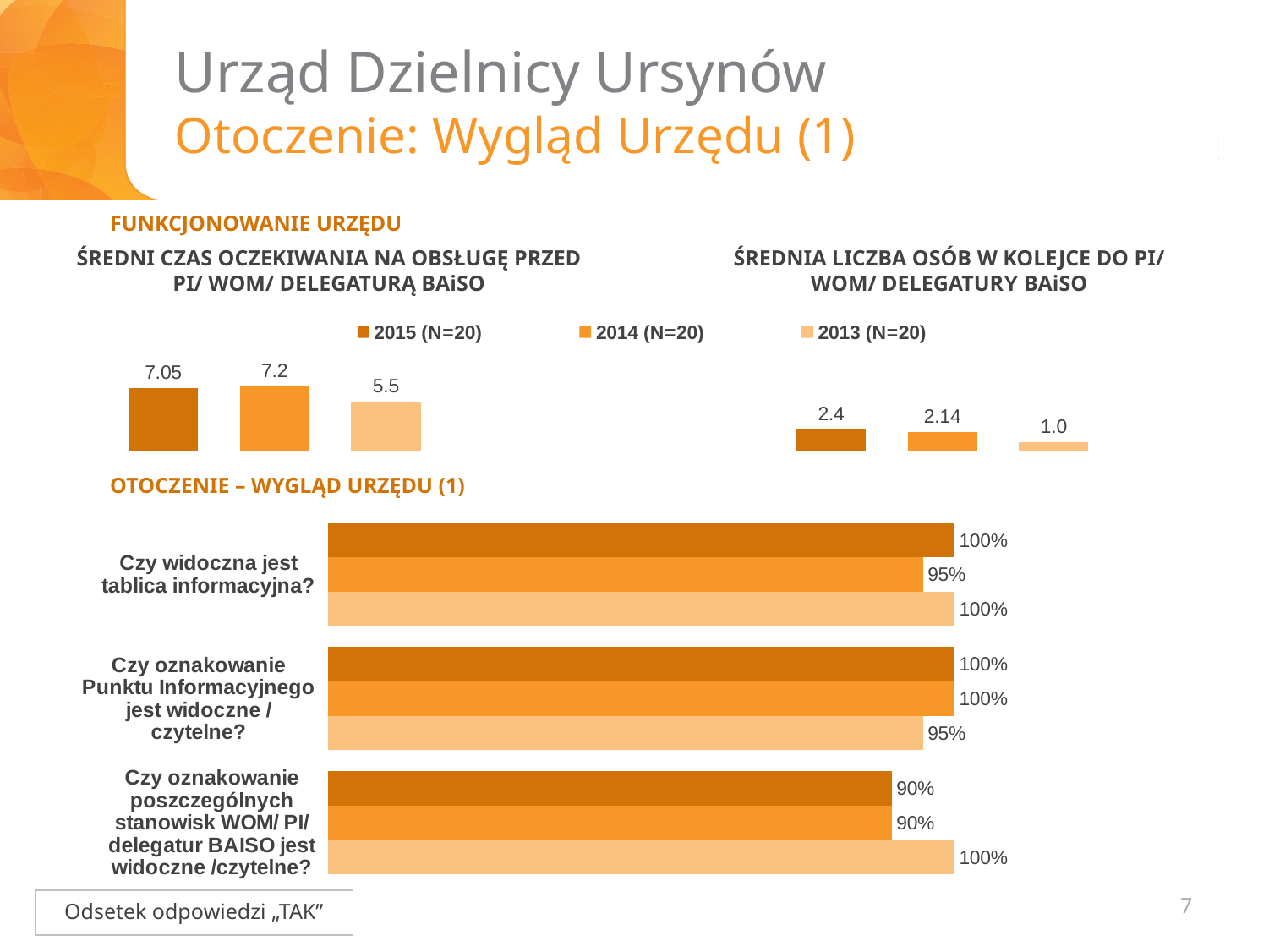
In the chart 'ŚREDNI CZAS OCZEKIWANIA NA OBSŁUGĘ PRZED PI/ WOM/ DELEGATURĄ BAiSO', what is the difference between the 2014 and 2013 values? 1.7 In the chart 'ŚREDNI CZAS OCZEKIWANIA NA OBSŁUGĘ PRZED PI/ WOM/ DELEGATURĄ BAiSO', what is the value for 2015 (N=20)? 7.05 In the chart 'OTOCZENIE – WYGLĄD URZĘDU (1)', what is the 2014 value for 'Czy widoczna jest tablica informacyjna?'? 95% In the chart 'OTOCZENIE – WYGLĄD URZĘDU (1)', how many questions (categories) are shown? 3 In the chart 'ŚREDNIA LICZBA OSÓB W KOLEJCE DO PI/ WOM/ DELEGATURY BAiSO', what is the difference between the 2015 and 2013 values? 1.4 In the chart 'OTOCZENIE – WYGLĄD URZĘDU (1)', what is the 2015 value for 'Czy oznakowanie poszczególnych stanowisk WOM/ PI/ delegatur BAISO jest widoczne /czytelne?'? 90% In the chart 'ŚREDNI CZAS OCZEKIWANIA NA OBSŁUGĘ PRZED PI/ WOM/ DELEGATURĄ BAiSO', which year has the lowest value? 2013 (N=20) What kind of chart is 'OTOCZENIE – WYGLĄD URZĘDU (1)'? Bar chart In the chart 'OTOCZENIE – WYGLĄD URZĘDU (1)', what is the 2013 value for 'Czy oznakowanie Punktu Informacyjnego jest widoczne / czytelne?'? 95% In the chart 'ŚREDNIA LICZBA OSÓB W KOLEJCE DO PI/ WOM/ DELEGATURY BAiSO', which year has the highest value? 2015 (N=20) How many series does the legend list for the charts on this slide? 3 In the chart 'ŚREDNIA LICZBA OSÓB W KOLEJCE DO PI/ WOM/ DELEGATURY BAiSO', what is the value for 2014 (N=20)? 2.14